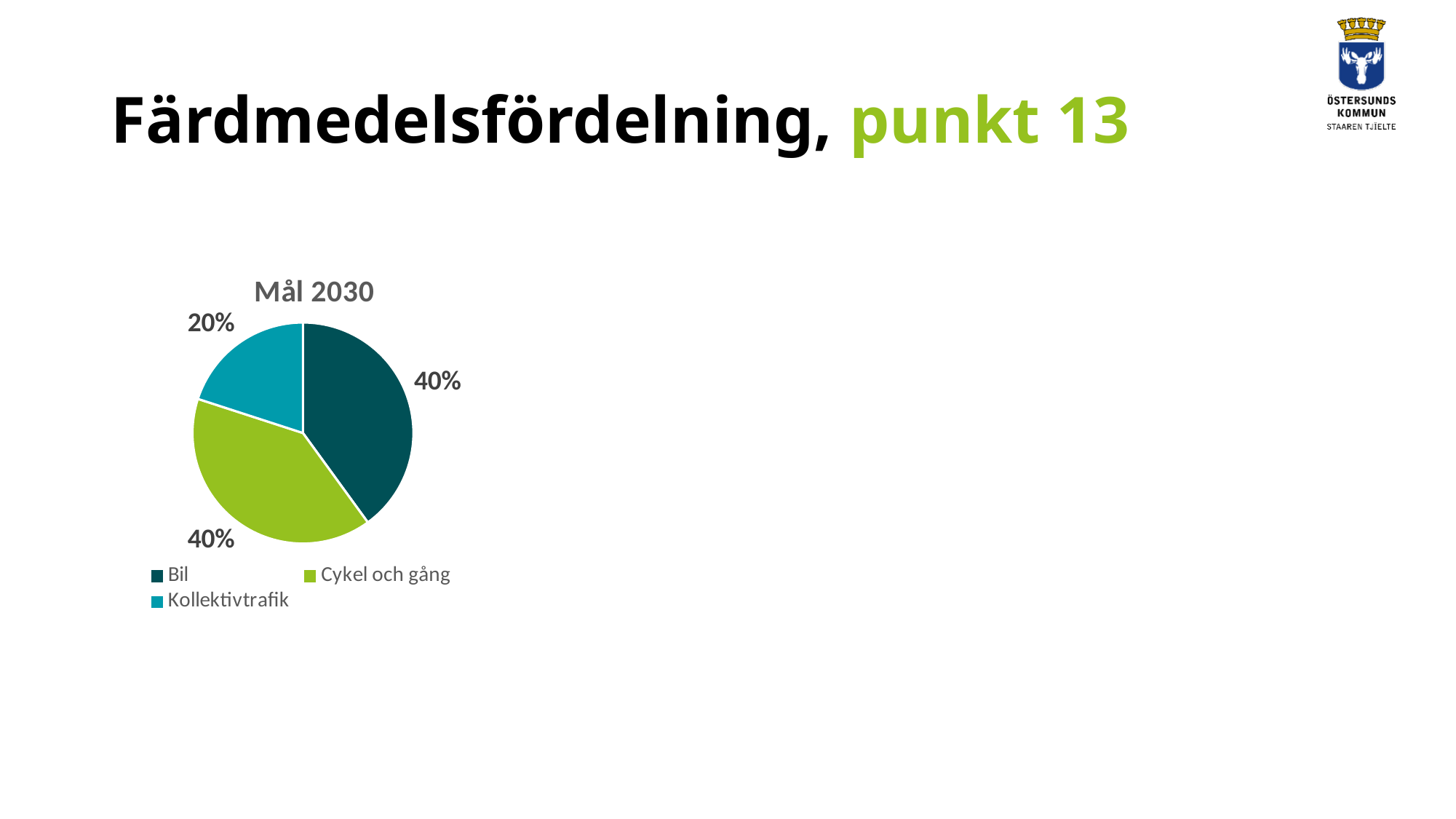
How many slices does the pie chart have? 3 What share of the pie does Bil have? 40% Which legend entry is shown in light green? Cykel och gång What is the combined share of Bil and Cykel och gång? 80% What is the difference between the share for Bil and the share for Kollektivtrafik? 20% What share of the pie does Cykel och gång have? 40% Which category has the smallest slice of the pie? Kollektivtrafik What is the title of the chart? Mål 2030 What share of the pie does Kollektivtrafik have? 20% Which is larger, the share for Cykel och gång or the share for Kollektivtrafik? Cykel och gång How many entries does the legend list? 3 What kind of chart is shown on the slide? pie chart